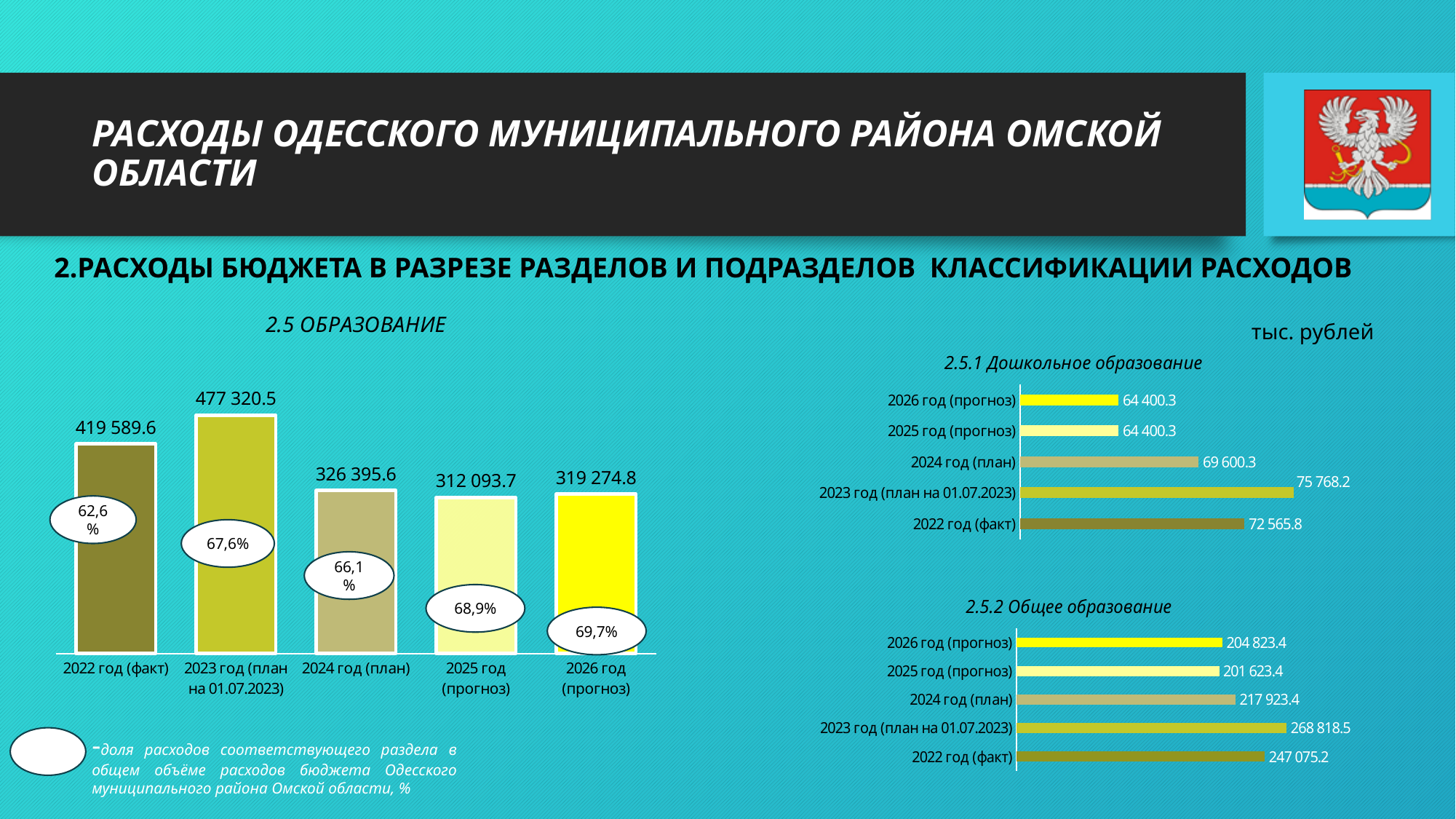
In the chart '2.5.2 Общее образование', which is larger: the value for 2025 год (прогноз) or 2026 год (прогноз)? 2026 год (прогноз) What kind of chart is '2.5 ОБРАЗОВАНИЕ'? bar chart In the chart '2.5.2 Общее образование', what is the value for 2022 год (факт)? 247 075.2 In the chart '2.5.1 Дошкольное образование', which year has the highest value? 2023 год (план на 01.07.2023) What unit of measurement is stated on the slide for the charts? тыс. рублей In the chart '2.5.1 Дошкольное образование', what is the value for 2024 год (план)? 69 600.3 In the chart '2.5 ОБРАЗОВАНИЕ', what is the value for 2023 год (план на 01.07.2023)? 477 320.5 In the chart '2.5 ОБРАЗОВАНИЕ', what share percentage is shown in the oval for 2026 год (прогноз)? 69,7% In the chart '2.5 ОБРАЗОВАНИЕ', what is the difference between the values for 2023 год (план на 01.07.2023) and 2022 год (факт)? 57 730.9 In the chart '2.5 ОБРАЗОВАНИЕ', which year has the lowest value? 2025 год (прогноз) In the chart '2.5.1 Дошкольное образование', how many bars are plotted? 5 In the chart '2.5.2 Общее образование', what is the difference between the values for 2023 год (план на 01.07.2023) and 2024 год (план)? 50 895.1